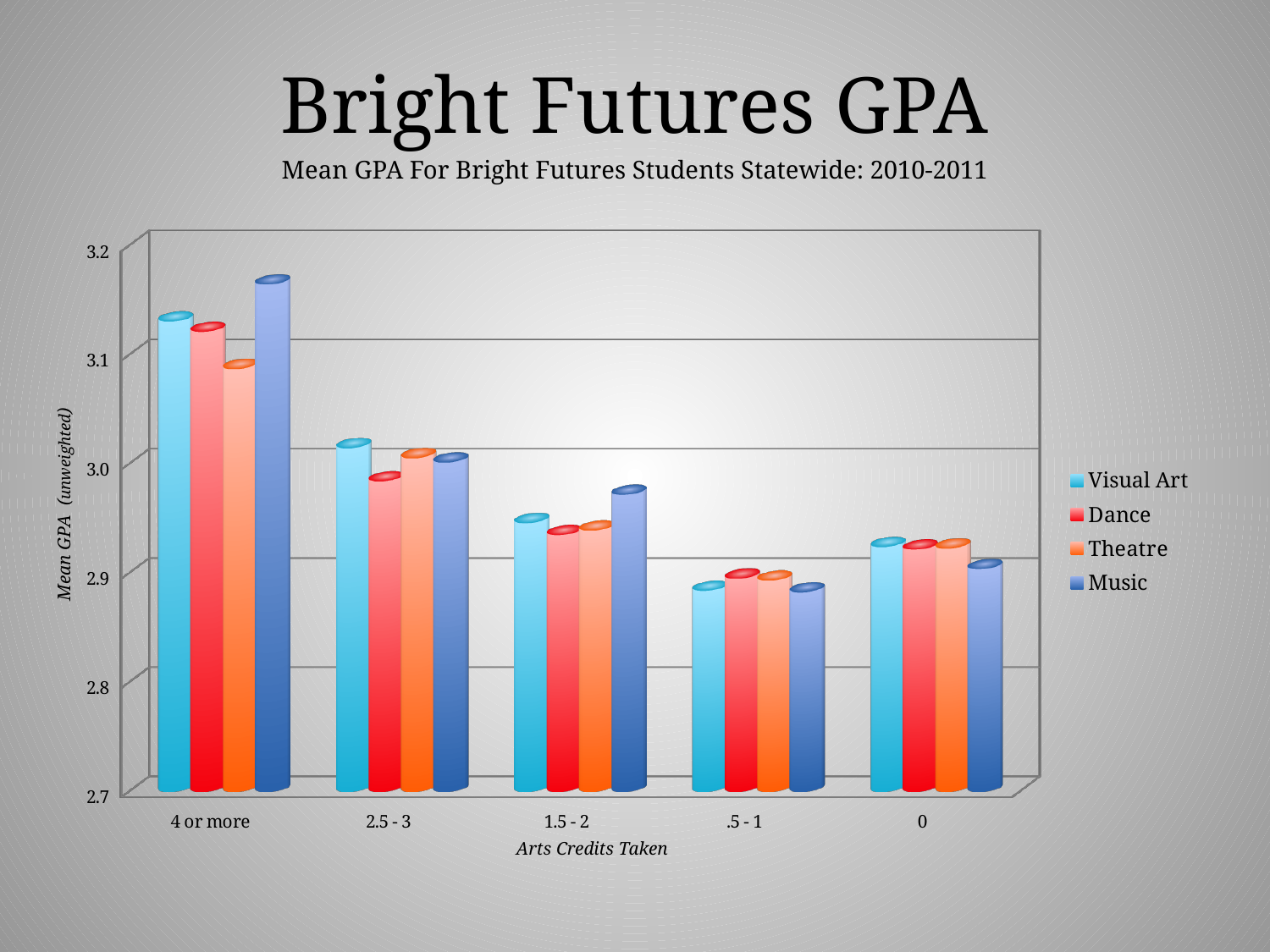
What is the title of the x axis? Arts Credits Taken Which series has the highest mean GPA in the '4 or more' category? Music In the '4 or more' category, which is larger: Music or Visual Art? Music What kind of chart is shown on the slide? bar chart How many series does the legend list? 4 In the '1.5 - 2' category, which is larger: Music or Dance? Music Is the Music value for '4 or more' greater or less than 3.1? greater Which series has the lowest mean GPA in the '4 or more' category? Theatre Is the Dance value for '2.5 - 3' greater or less than 3.0? less How many Arts Credits Taken categories are shown on the x axis? 5 Does the Music value rise or fall from '4 or more' to '.5 - 1'? fall Is the Music value for '1.5 - 2' greater or less than 3.0? less